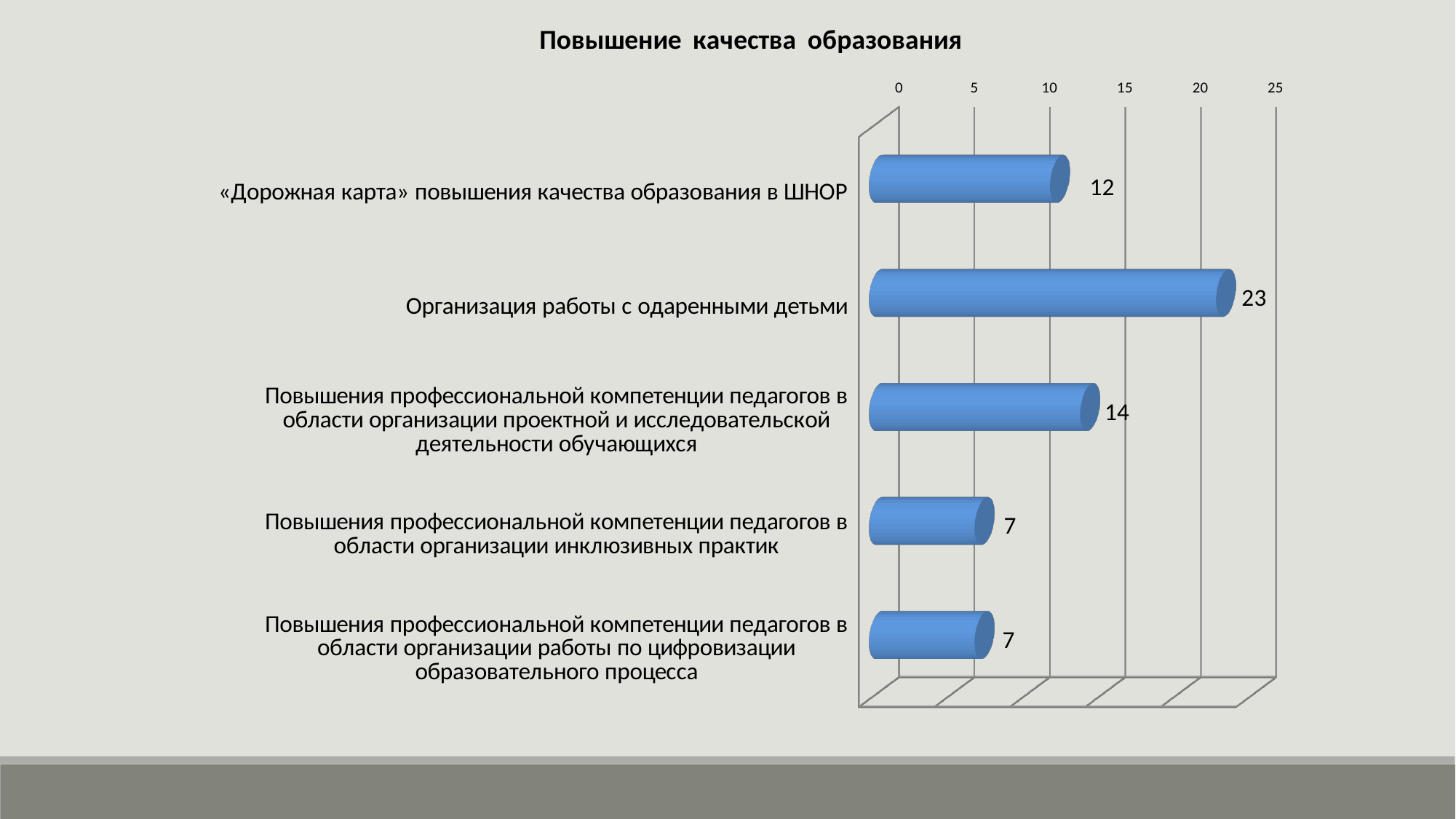
How many categories are shown in the chart? 5 What is the difference between the values for Повышения профессиональной компетенции педагогов в области организации проектной и исследовательской деятельности обучающихся and Повышения профессиональной компетенции педагогов в области организации инклюзивных практик? 7 What kind of chart is shown on the slide? bar chart What is the value for Повышения профессиональной компетенции педагогов в области организации инклюзивных практик? 7 What is the difference between the values for Организация работы с одаренными детьми and «Дорожная карта» повышения качества образования в ШНОР? 11 What is the value for «Дорожная карта» повышения качества образования в ШНОР? 12 What is the title of the chart? Повышение качества образования Is the value for Организация работы с одаренными детьми greater or less than 20? greater Which category has the highest value? Организация работы с одаренными детьми What is the value for Организация работы с одаренными детьми? 23 Which is larger: the value for «Дорожная карта» повышения качества образования в ШНОР or the value for Повышения профессиональной компетенции педагогов в области организации проектной и исследовательской деятельности обучающихся? Повышения профессиональной компетенции педагогов в области организации проектной и исследовательской деятельности обучающихся What is the value for Повышения профессиональной компетенции педагогов в области организации проектной и исследовательской деятельности обучающихся? 14